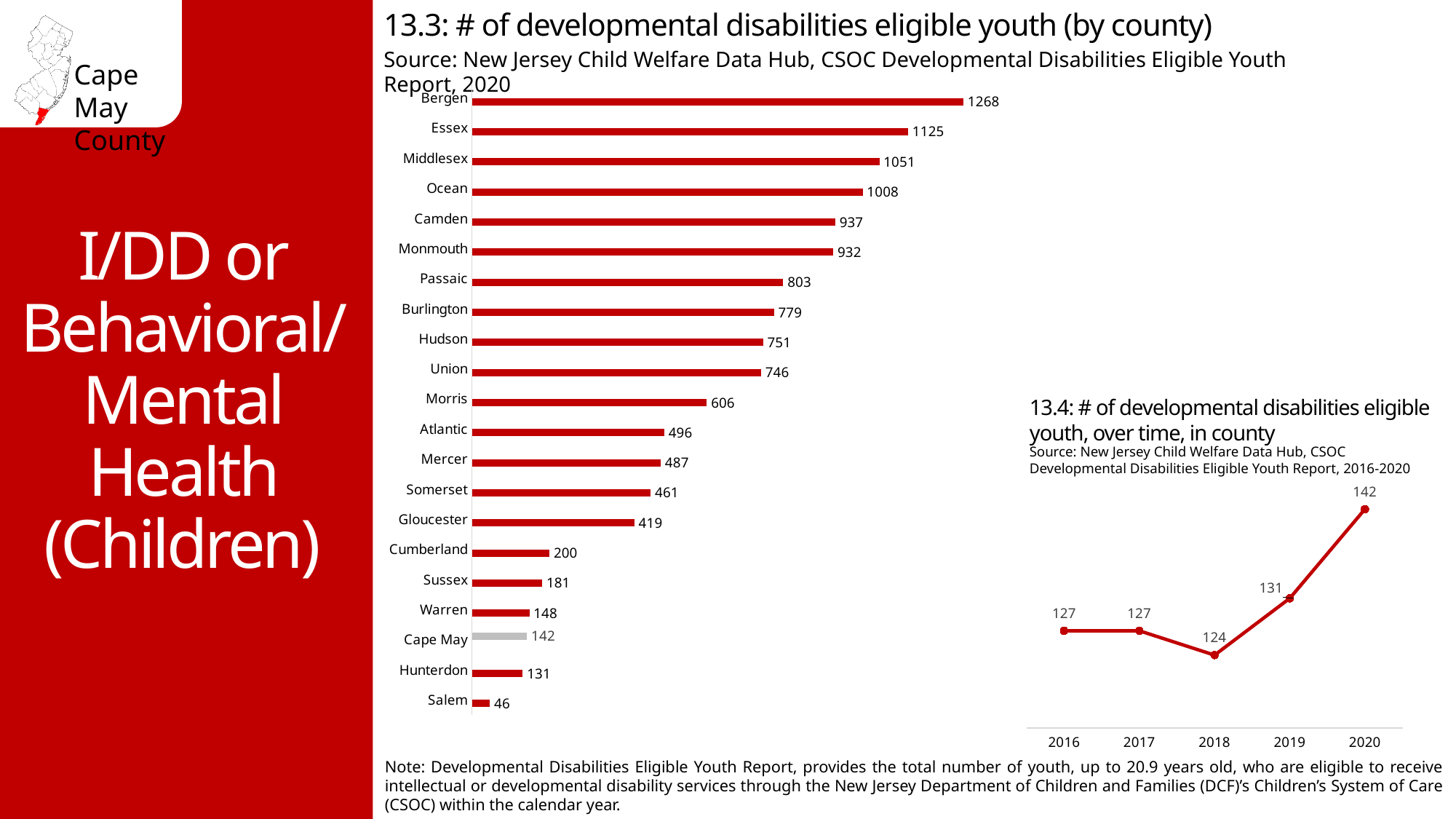
In the chart '13.4: # of developmental disabilities eligible youth, over time, in county', what is the difference between 2020 and 2019? 11 In the chart '13.3: # of developmental disabilities eligible youth (by county)', which county has the lowest value? Salem In the chart '13.3: # of developmental disabilities eligible youth (by county)', what is the value for Cape May? 142 What kind of chart is '13.3: # of developmental disabilities eligible youth (by county)'? Bar chart In the chart '13.3: # of developmental disabilities eligible youth (by county)', how many counties are shown? 21 What kind of chart is '13.4: # of developmental disabilities eligible youth, over time, in county'? Line chart In the chart '13.3: # of developmental disabilities eligible youth (by county)', what is the difference between Bergen and Essex? 143 In the chart '13.4: # of developmental disabilities eligible youth, over time, in county', which year has the highest value? 2020 In the chart '13.3: # of developmental disabilities eligible youth (by county)', which is larger, Camden or Monmouth? Camden In the chart '13.3: # of developmental disabilities eligible youth (by county)', what is the value for Gloucester? 419 In the chart '13.3: # of developmental disabilities eligible youth (by county)', which county has the highest value? Bergen In the chart '13.4: # of developmental disabilities eligible youth, over time, in county', what is the value for 2018? 124